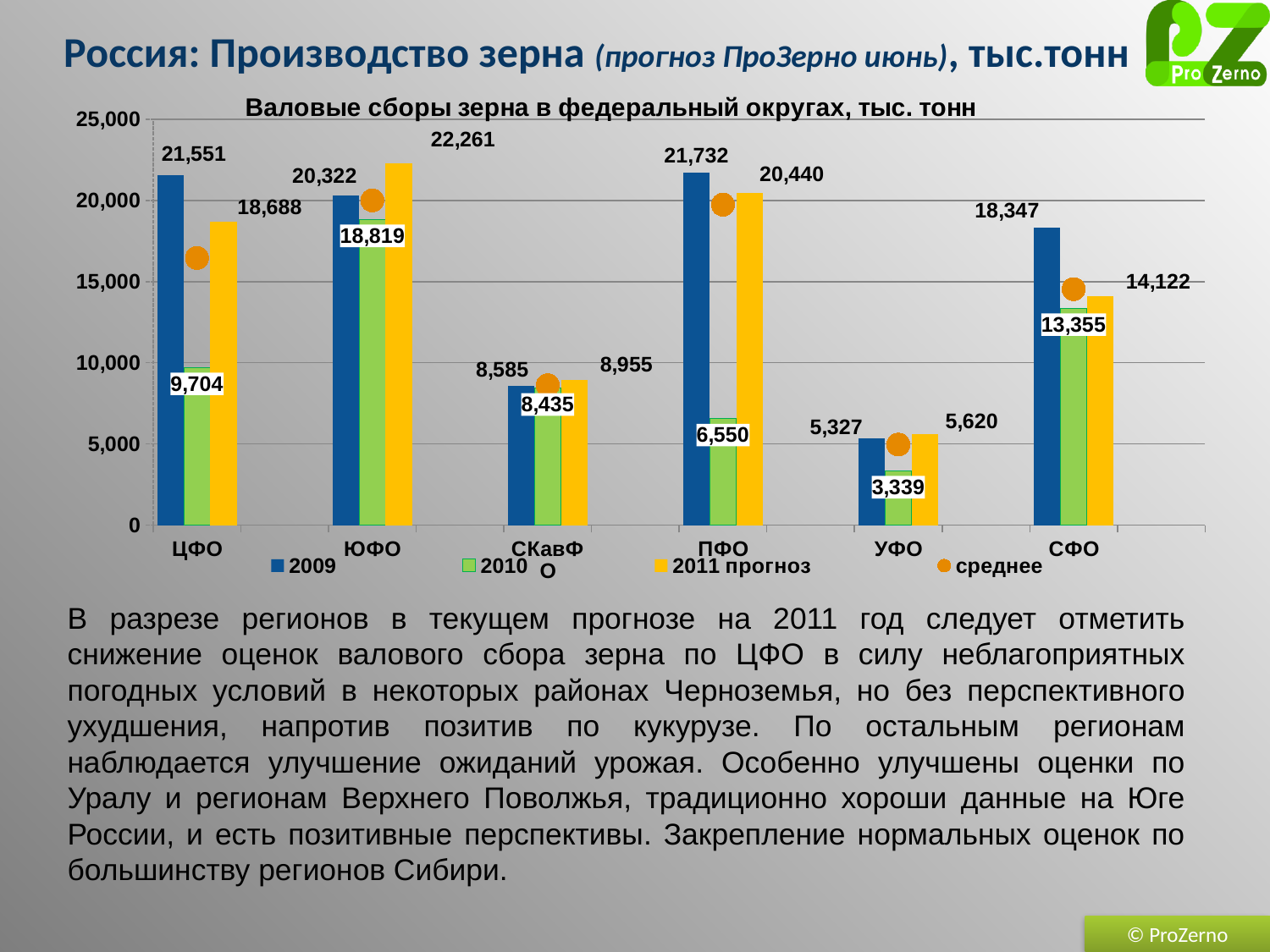
Which has the larger 2011 прогноз value, ЦФО or СФО? ЦФО By how much does the 2011 прогноз for ЮФО exceed its 2009 value? 1,939 What is the difference between the 2009 and 2010 values for ЦФО? 11,847 What is the 2009 value for СФО? 18,347 Is the среднее value for ЦФО greater or less than 15,000? greater What kind of chart is shown on the slide? bar chart Which federal district has the highest 2009 value? ПФО What is the 2011 прогноз value for ЮФО? 22,261 How many series does the legend list? 4 How many federal districts are shown on the x axis? 6 What is the 2010 value for ПФО? 6,550 Which federal district has the lowest 2010 value? УФО